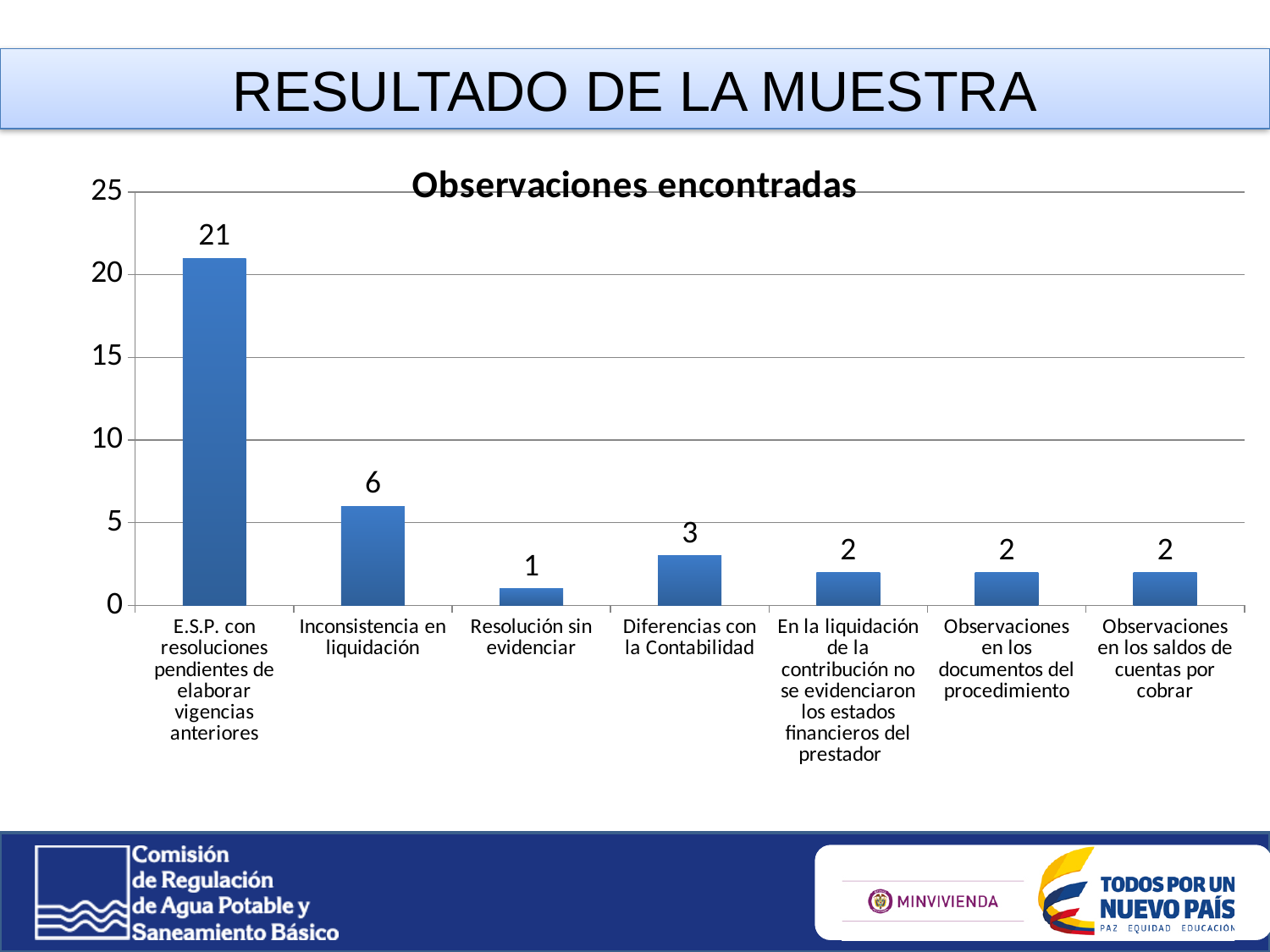
Which is larger, the value for 'Diferencias con la Contabilidad' or the value for 'Observaciones en los documentos del procedimiento'? Diferencias con la Contabilidad What is the value for 'Inconsistencia en liquidación'? 6 Which category has the lowest value? Resolución sin evidenciar What is the title of the chart? Observaciones encontradas What is the value for 'Observaciones en los saldos de cuentas por cobrar'? 2 Which category has the highest value? E.S.P. con resoluciones pendientes de elaborar vigencias anteriores What is the value for 'Diferencias con la Contabilidad'? 3 How many categories are shown in the chart? 7 What kind of chart is shown on the slide? Bar chart What is the value for 'Resolución sin evidenciar'? 1 What is the difference between the values for 'E.S.P. con resoluciones pendientes de elaborar vigencias anteriores' and 'Inconsistencia en liquidación'? 15 Is the value for 'E.S.P. con resoluciones pendientes de elaborar vigencias anteriores' greater or less than 20? greater